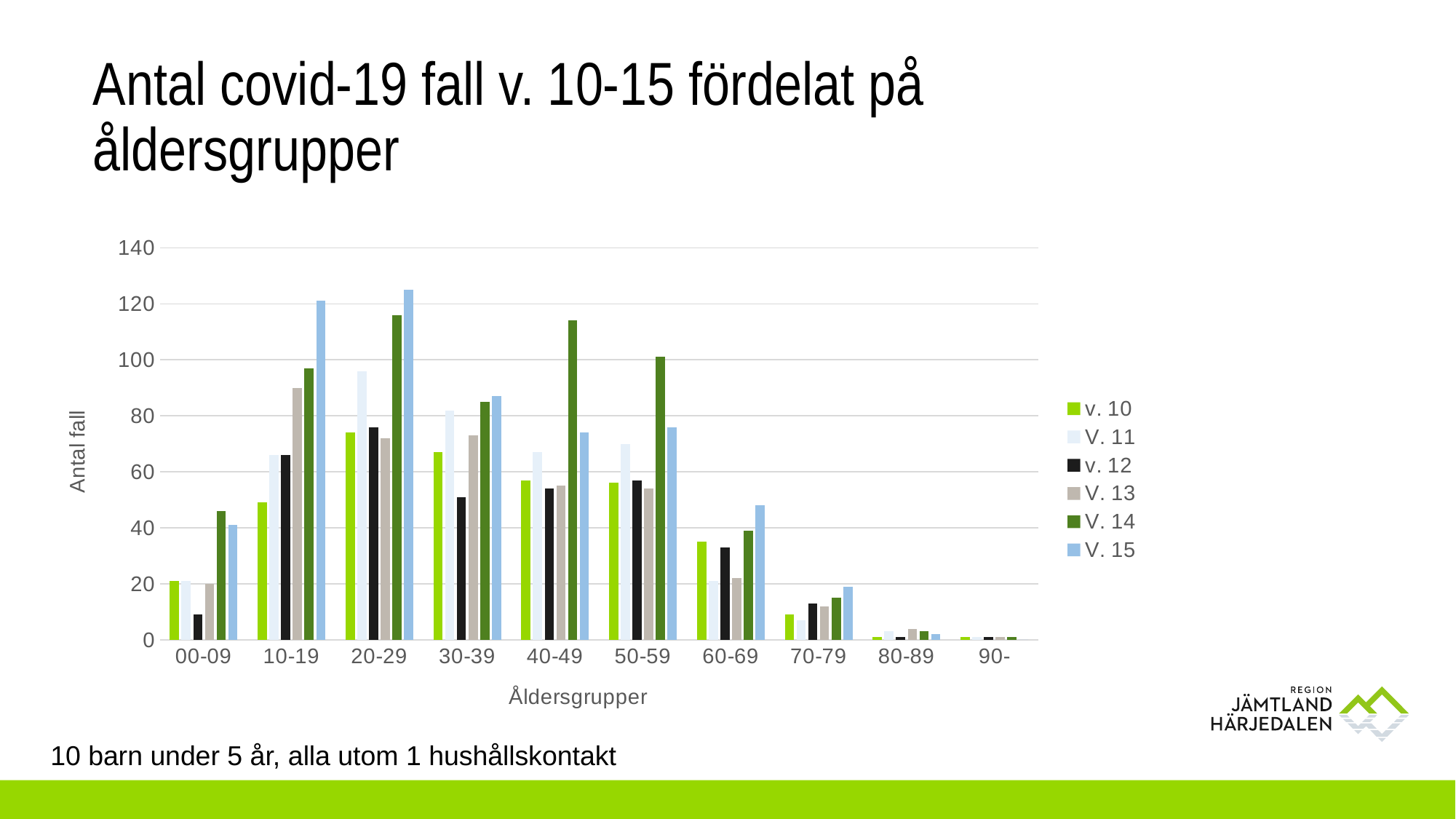
Is the value for V. 14 in the 40-49 age group greater or less than 100? greater What kind of chart is shown on the slide? Bar chart Which series has the lowest bar in the 00-09 age group? v. 12 What is the title of the y axis? Antal fall How many series does the legend list? 6 In the 10-19 age group, which is larger: V. 14 or V. 15? V. 15 Which age group has the highest V. 15 bar? 20-29 Which series has the highest bar in the 40-49 age group? V. 14 Is the value for V. 15 in the 20-29 age group greater or less than 120? greater How many age groups are shown on the x axis? 10 Is the value for v. 12 in the 00-09 age group greater or less than 20? less What is the title of the x axis? Åldersgrupper